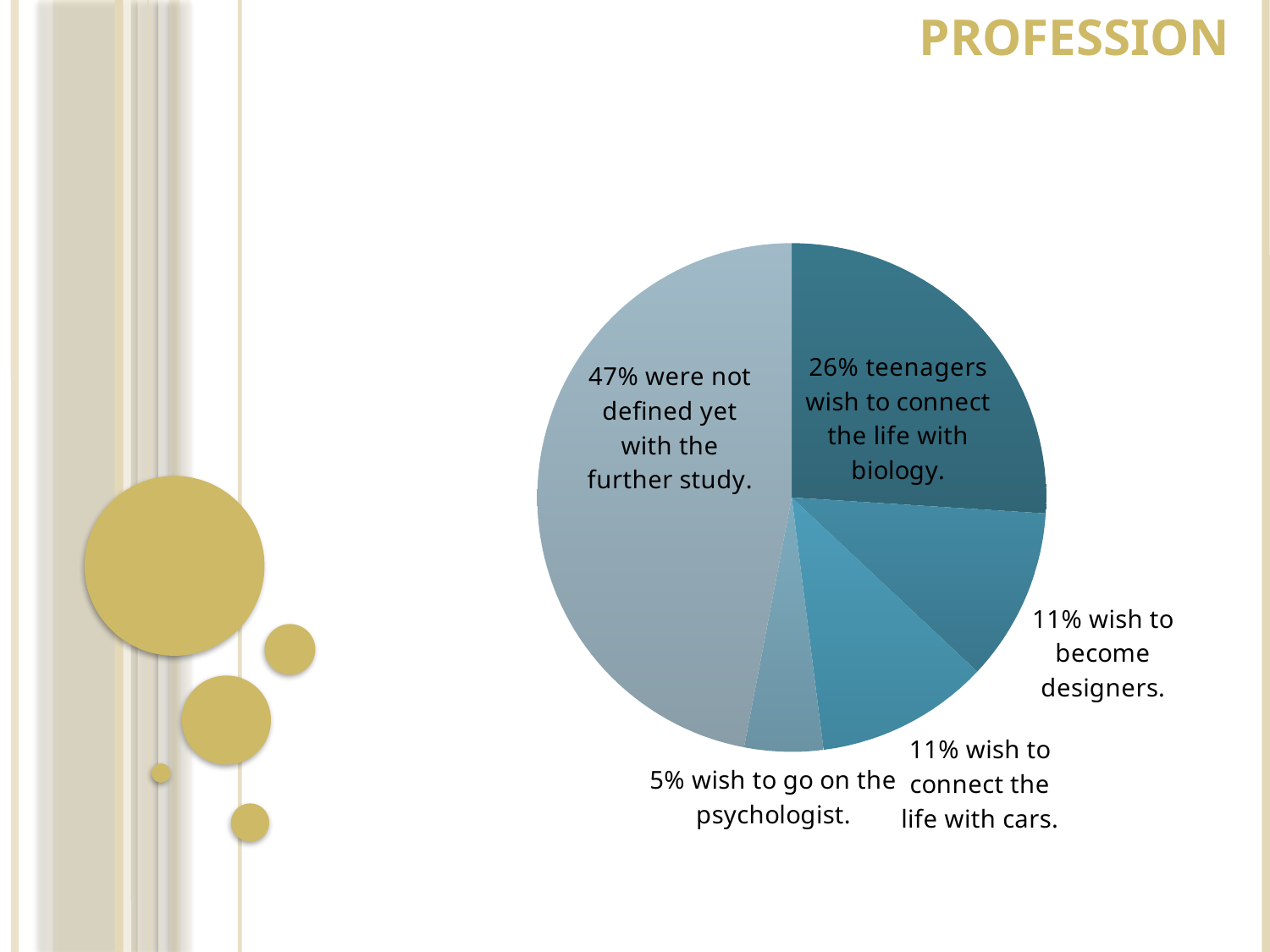
Which is larger: the share wishing to connect their life with biology or the share wishing to become designers? Connect the life with biology What percentage of teenagers wish to connect their life with biology? 26% Which category has the largest share of the pie? Not defined yet with the further study What percentage were not defined yet with the further study? 47% Which category has the smallest share of the pie? Wish to go on the psychologist What is the title of the slide containing the chart? PROFESSION What percentage wish to go on the psychologist? 5% What percentage wish to become designers? 11% What kind of chart is shown on the slide? Pie chart What is the difference between the share of those not defined yet and those who wish to connect their life with biology? 21% How many slices does the pie chart have? 5 What is the combined share of those who wish to become designers and those who wish to connect their life with cars? 22%